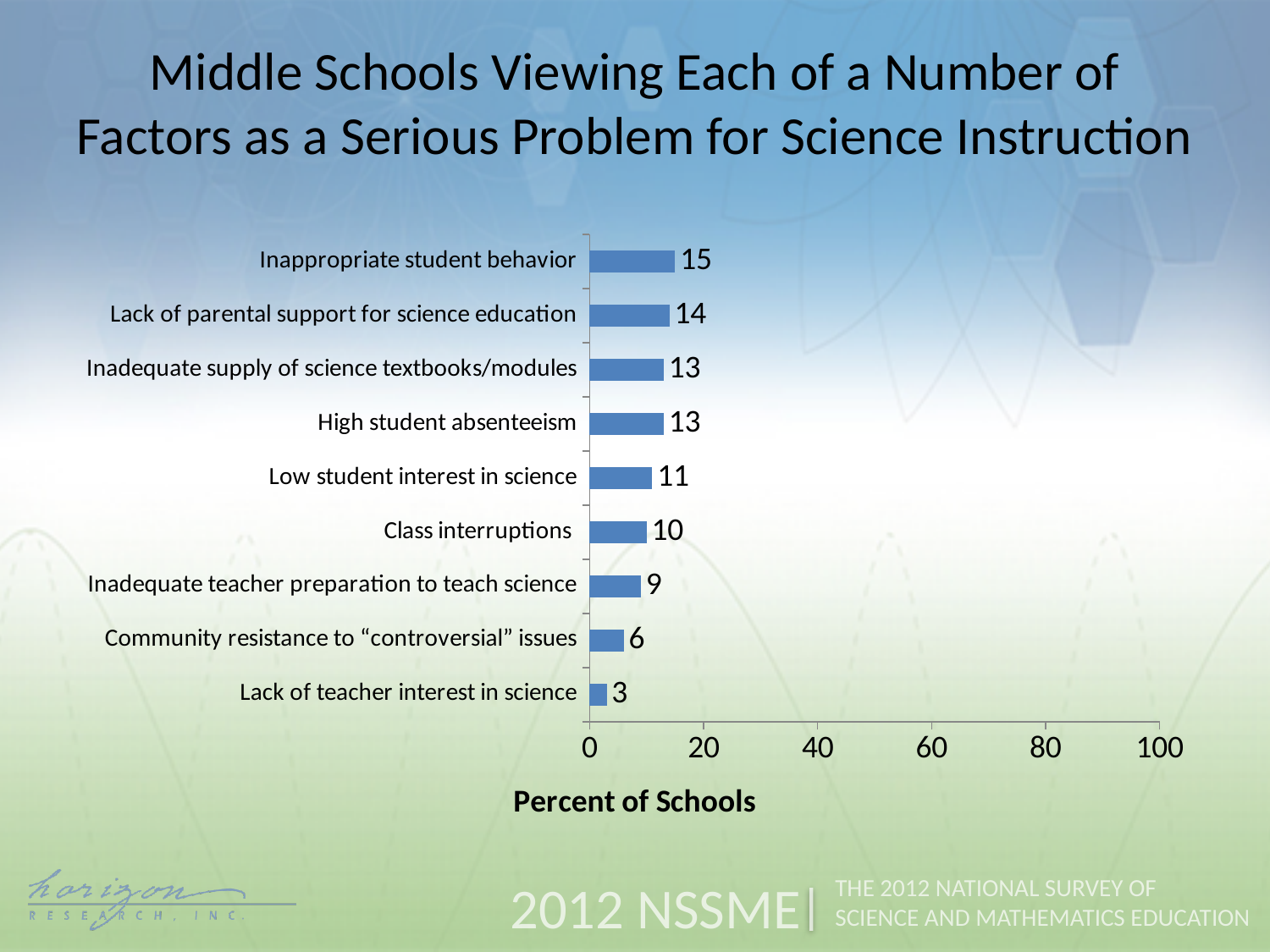
Which is larger: the value for 'Low student interest in science' or the value for 'Inadequate teacher preparation to teach science'? Low student interest in science Which factor has the lowest percent of schools viewing it as a serious problem? Lack of teacher interest in science What is the label of the horizontal axis? Percent of Schools How many factors are shown in the chart? 9 What percent of middle schools view inappropriate student behavior as a serious problem for science instruction? 15 Is the value for 'High student absenteeism' greater or less than 20? less What is the value for 'Lack of parental support for science education'? 14 What percent of schools view class interruptions as a serious problem? 10 What kind of chart is shown on the slide? Bar chart What is the difference between the values for 'Inappropriate student behavior' and 'Lack of teacher interest in science'? 12 Which factor has the highest percent of schools viewing it as a serious problem? Inappropriate student behavior What is the maximum value shown on the horizontal axis? 100